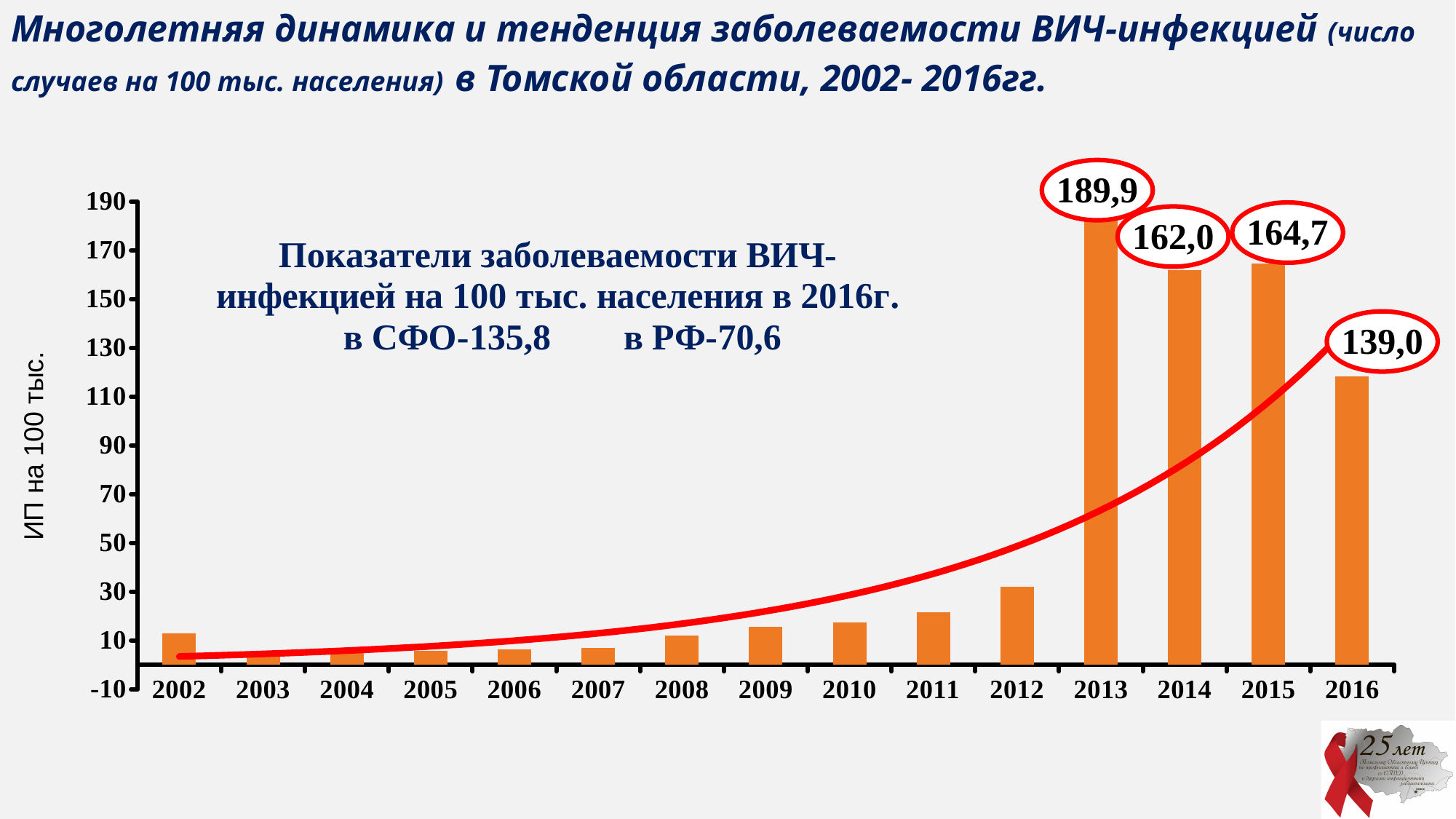
Which year has the highest value? 2013 What is the value labelled for 2016? 139,0 What is the difference between the values for 2013 and 2014? 27,9 Is the value for 2012 greater or less than 50? less What kind of chart is this? bar chart What is the value for 2015? 164,7 What is the value for 2013? 189,9 What is the difference between the values for 2015 and 2014? 2,7 Which is larger, the value for 2014 or the value for 2015? 2015 How many years are shown on the x axis? 15 What is the value for 2014? 162,0 Do the values generally rise or fall from 2002 to 2013? rise